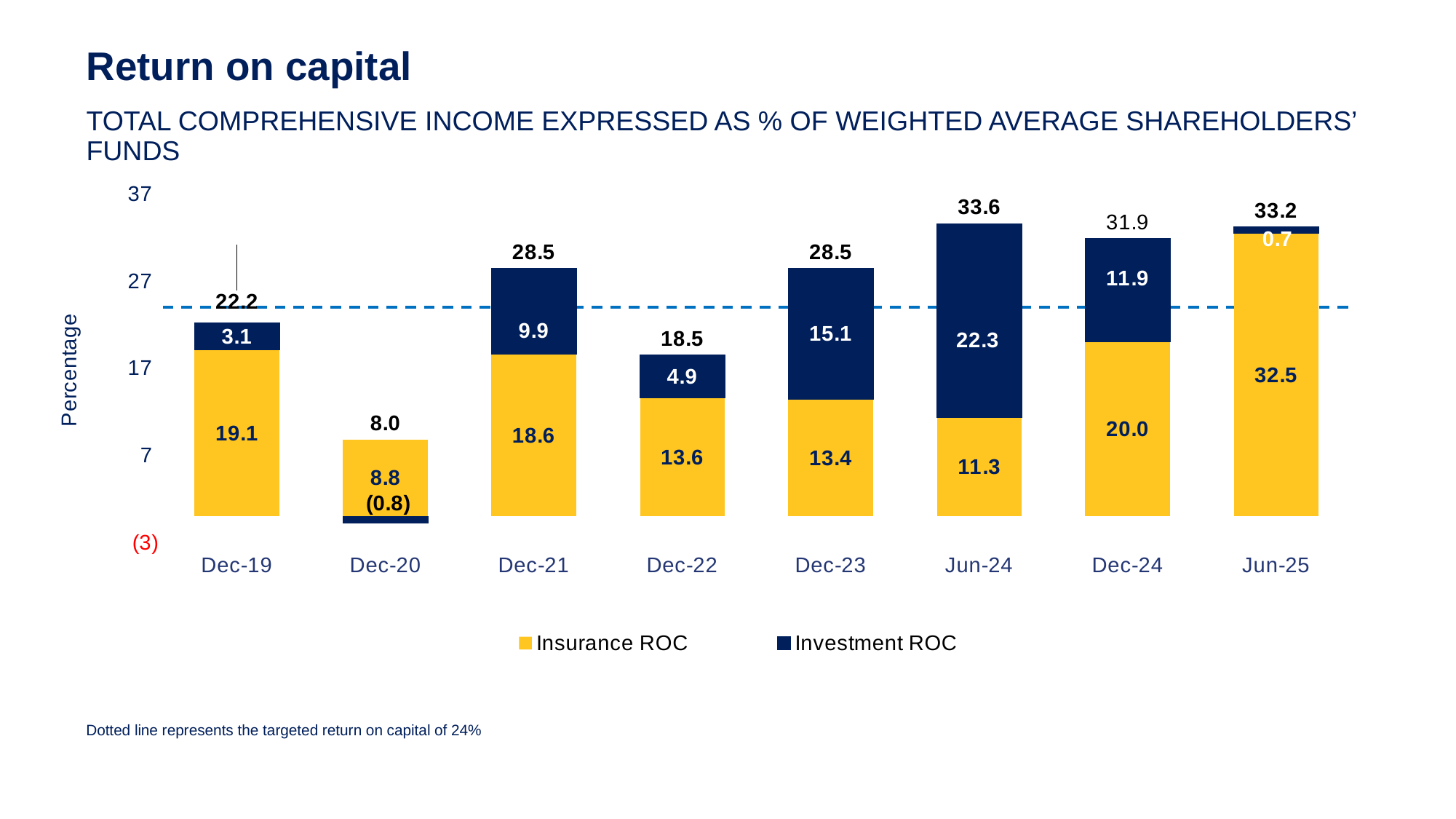
Which is larger, the Insurance ROC for Dec-24 or for Dec-19? Dec-24 What is the Investment ROC value for Dec-20? (0.8) What is the Insurance ROC value for Dec-21? 18.6 What kind of chart is shown on the slide? Stacked bar chart Which period has the lowest total return on capital? Dec-20 How many periods are shown on the x axis? 8 What is the total return on capital shown for Dec-22? 18.5 What does the dotted line on the chart represent? Targeted return on capital of 24% What is the difference between the Investment ROC for Dec-23 and Dec-22? 10.2 How many series does the legend list? 2 Which period has the highest total return on capital? Jun-24 What is the Investment ROC value for Jun-24? 22.3